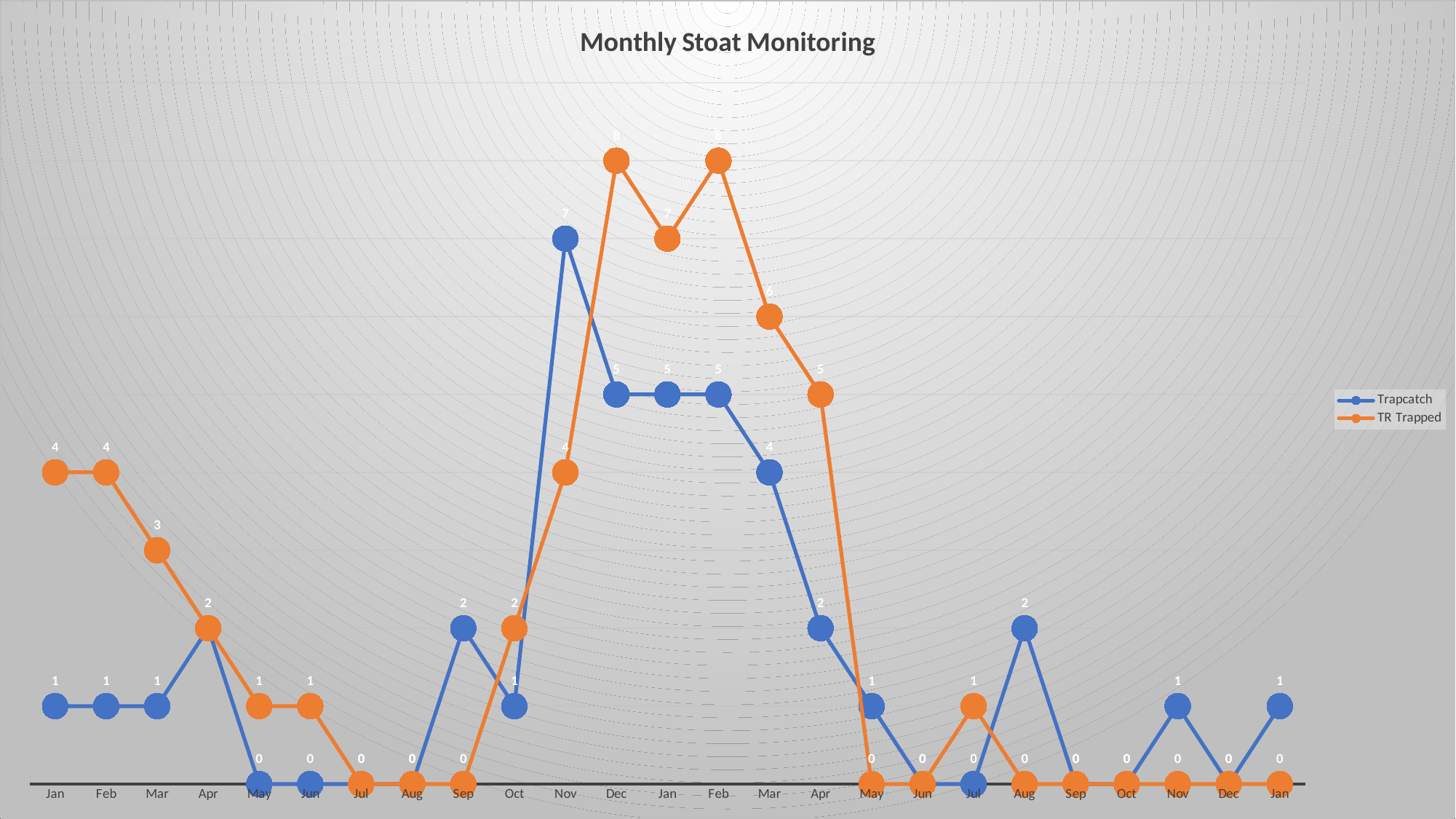
At which month does the Trapcatch series reach its highest value? Nov (the first one) What is the Trapcatch value for the second Aug on the x axis? 2 What is the TR Trapped value for the second Mar on the x axis? 6 Does the TR Trapped series rise or fall from the first Jan to the first Jul? Fall What is the title of the chart? Monthly Stoat Monitoring How many series does the legend list? 2 How many months are plotted along the x axis? 25 At the first Jan, which series has the larger value, Trapcatch or TR Trapped? TR Trapped At the first Dec, what is the difference between the TR Trapped value and the Trapcatch value? 3 What is the TR Trapped value for the first Dec on the x axis? 8 What is the Trapcatch value for the first Nov on the x axis? 7 What type of chart is shown on the slide? Line chart